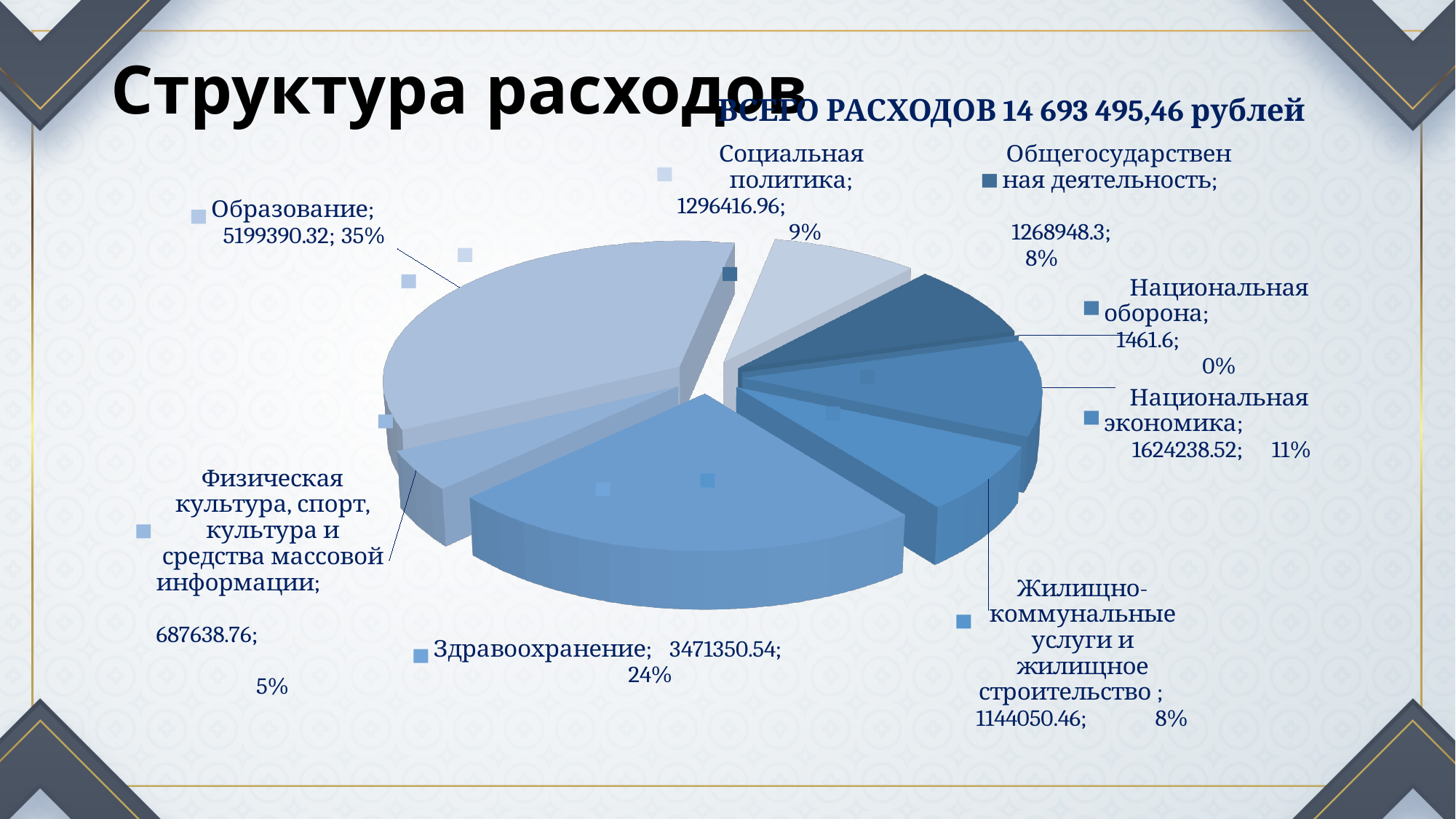
How many categories are shown in the pie chart? 8 Which category has the smallest slice of the pie? Национальная оборона What share of the pie does Социальная политика take? 9% What total expenditure is stated above the chart? 14 693 495,46 рублей Which category has the largest slice of the pie? Образование What is the value for Физическая культура, спорт, культура и средства массовой информации? 687638.76 What kind of chart is shown on the slide? pie chart What is the difference between the values for Образование and Здравоохранение? 1728039.78 Which is larger, Здравоохранение or Национальная экономика? Здравоохранение What is the value for Национальная экономика? 1624238.52 What is the value for Образование? 5199390.32 What share of the pie does Здравоохранение take? 24%